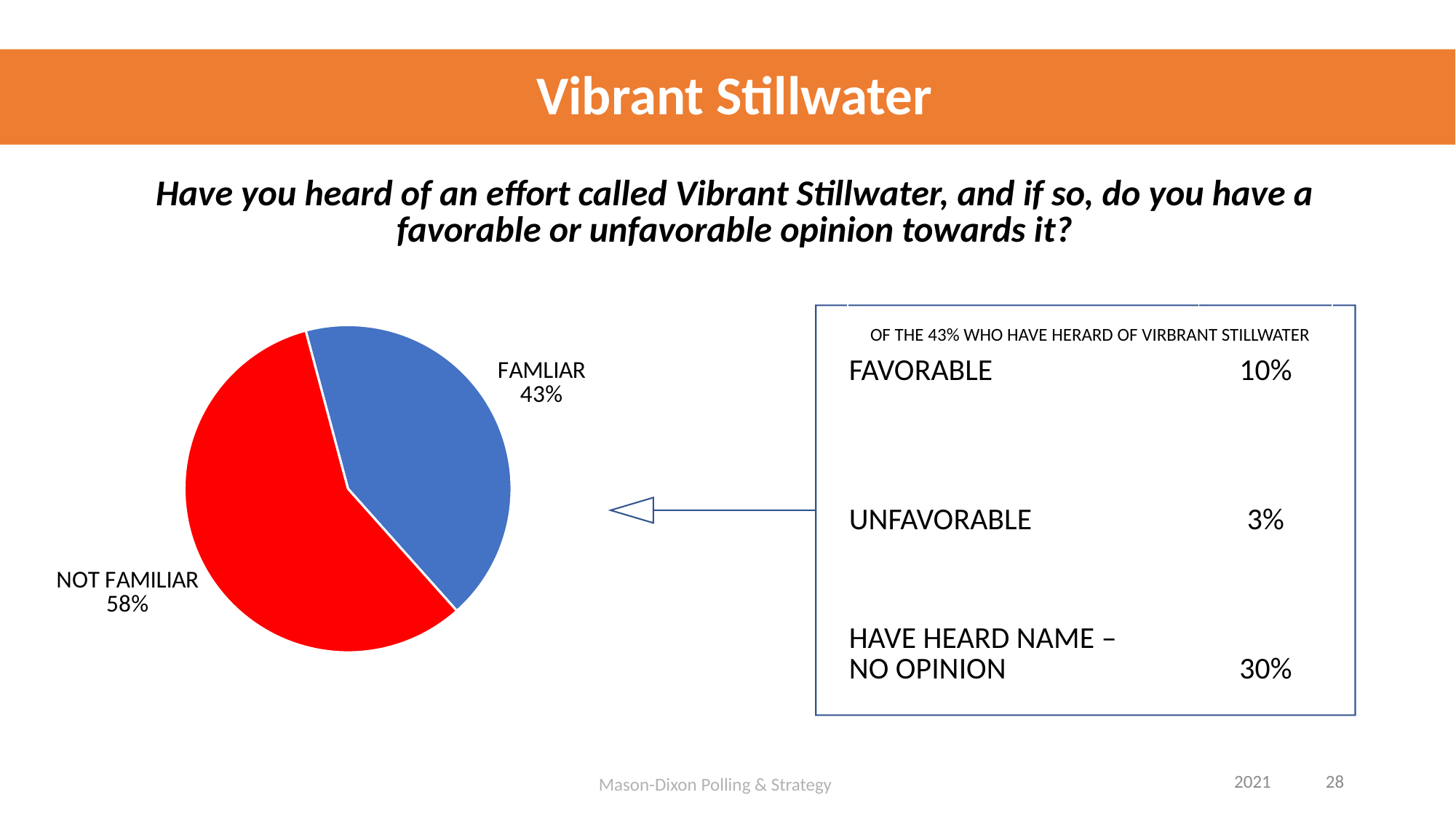
What is the difference in percentage points between the NOT FAMILIAR and FAMLIAR slices? 15 What kind of chart is shown on the slide? pie chart Is the FAMLIAR slice of the pie chart greater or less than half of the pie? less What colour is the NOT FAMILIAR slice of the pie chart? red How many slices does the pie chart have? 2 What percentage of respondents are labelled FAMLIAR in the pie chart? 43% What percentage of respondents are labelled NOT FAMILIAR in the pie chart? 58% Which is larger in the pie chart, FAMLIAR or NOT FAMILIAR? NOT FAMILIAR What colour is the FAMLIAR slice of the pie chart? blue Which slice of the pie chart is the smallest? FAMLIAR Which slice of the pie chart is the largest? NOT FAMILIAR